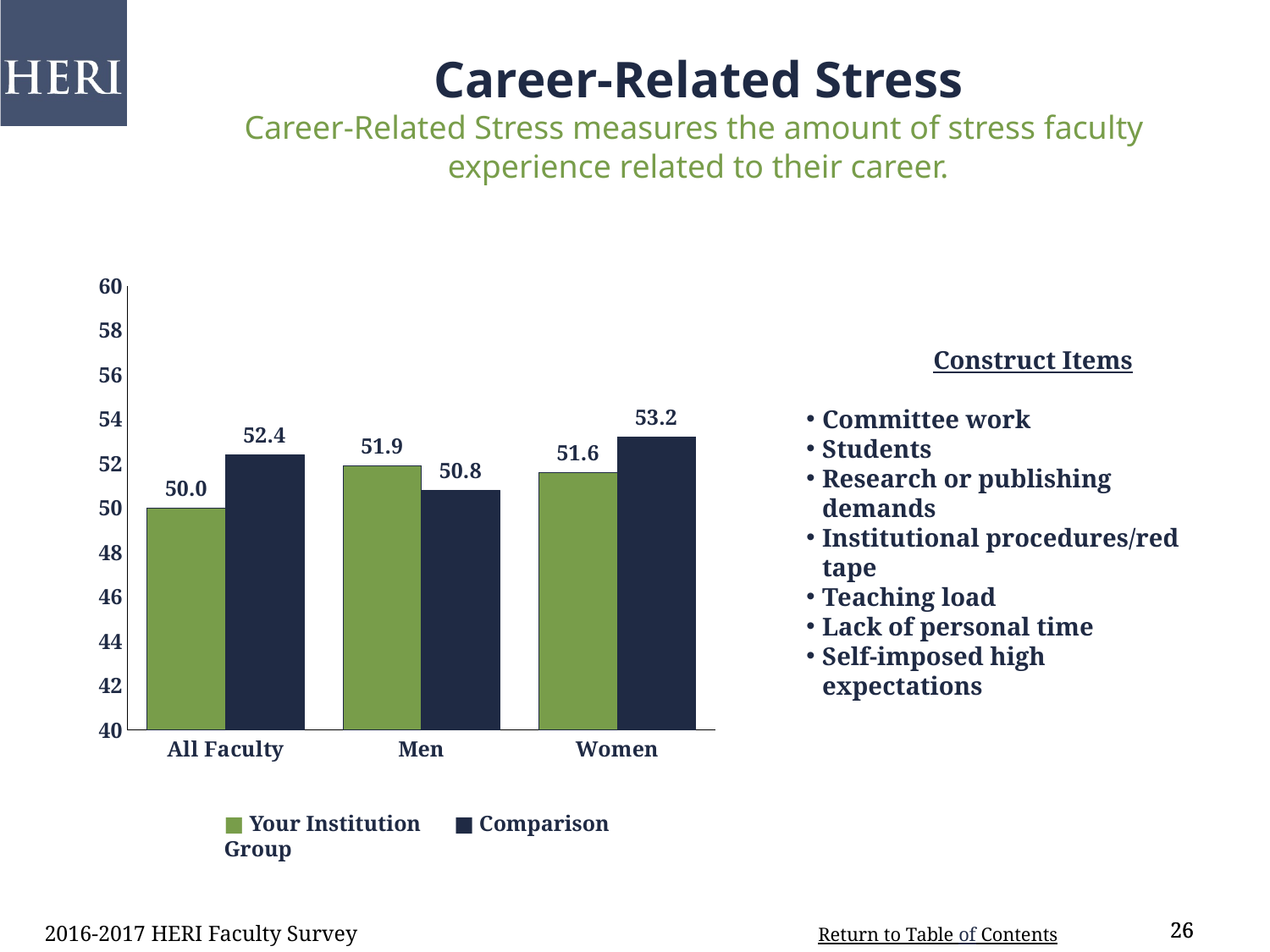
What is the Your Institution value for Men? 51.9 What kind of chart is shown on the slide? Bar chart What is the Comparison Group value for Women? 53.2 Which category has the highest Comparison Group value? Women What is the difference between the Comparison Group and Your Institution values for All Faculty? 2.4 Which series is shown in green in the legend? Your Institution How many categories are shown on the x axis? 3 How many series does the legend list? 2 What is the Your Institution value for All Faculty? 50.0 Which category has the lowest Your Institution value? All Faculty For Men, which is larger: the Your Institution value or the Comparison Group value? Your Institution What is the Comparison Group value for Men? 50.8